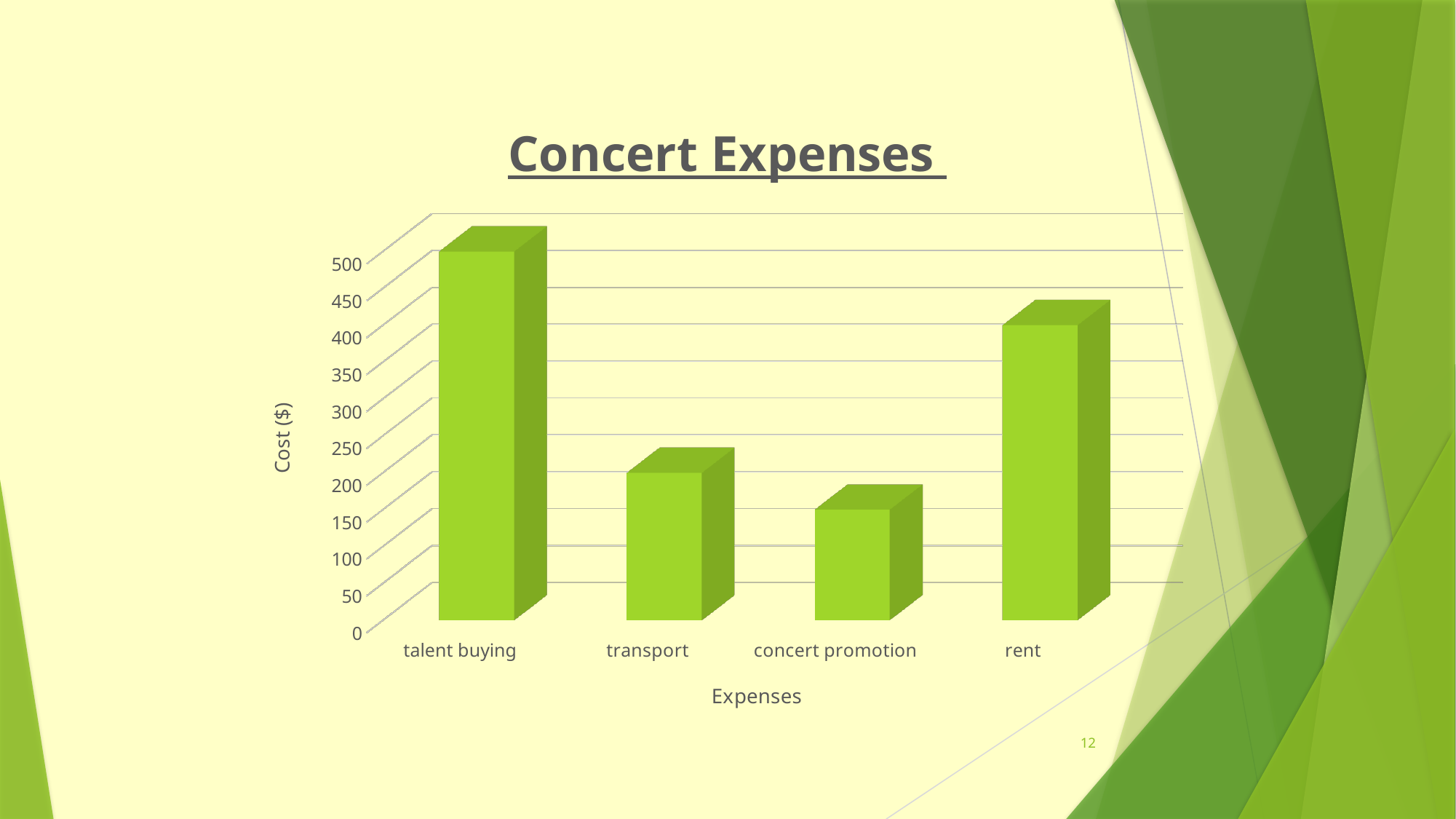
How many expense categories are plotted in the chart? 4 Which has a higher cost, transport or concert promotion? transport What is the label on the vertical axis of the chart? Cost ($) Which expense category has the highest cost? talent buying Is the value for talent buying greater or less than 450? greater Is the value for rent greater or less than 350? greater What is the title of the chart? Concert Expenses Which has a higher cost, rent or transport? rent What type of chart is shown on the slide? bar chart Is the value for concert promotion greater or less than 200? less Which expense category has the lowest cost? concert promotion